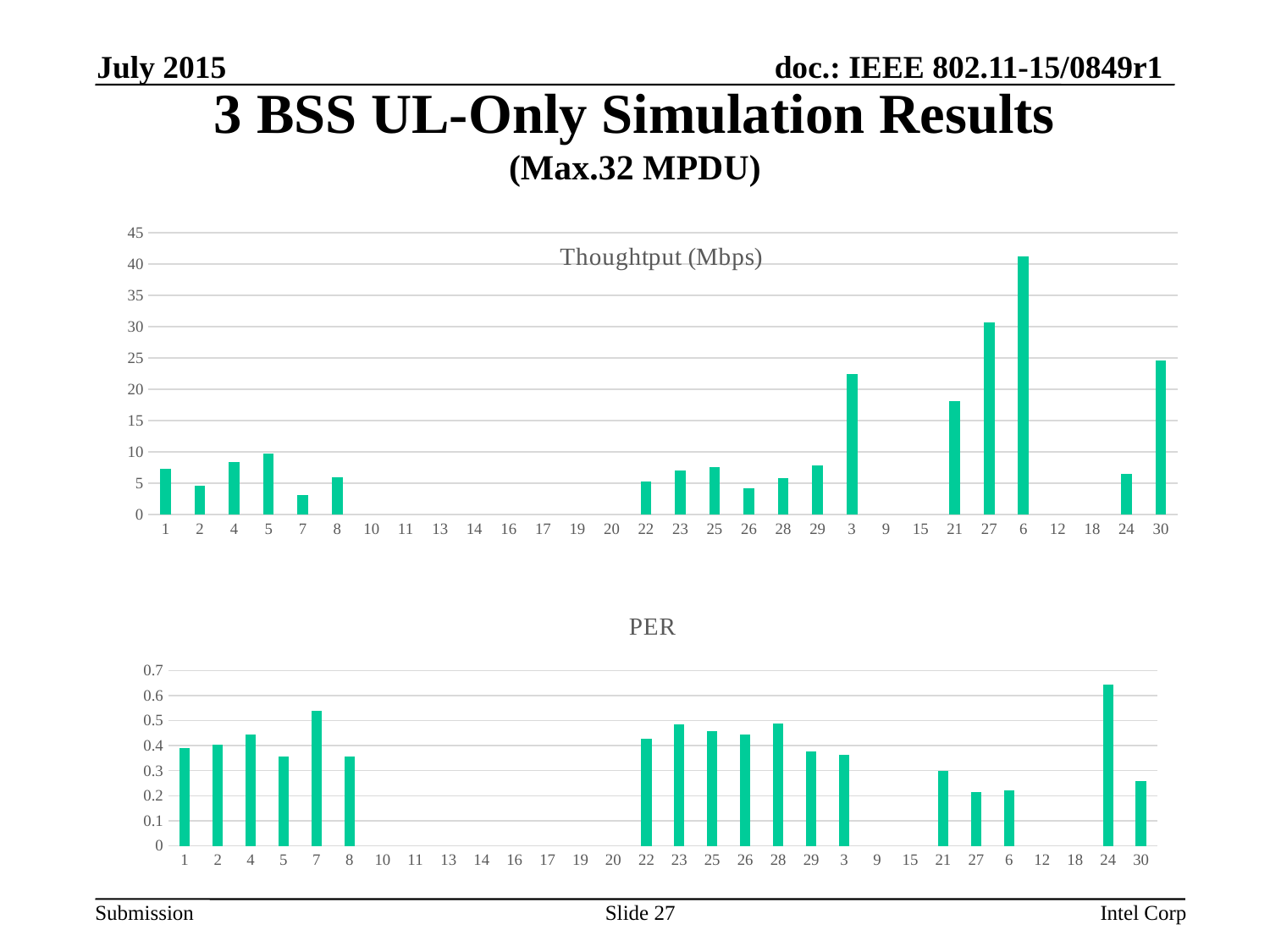
In the top chart (Thoughtput (Mbps)), which is larger, the value for category 6 or category 27? 6 In the bottom chart (PER), is the value for category 27 greater or less than 0.3? less What kind of chart is the top chart titled "Thoughtput (Mbps)"? bar chart In the top chart (Thoughtput (Mbps)), is the value for category 21 greater or less than 15? greater In the top chart (Thoughtput (Mbps)), is the value for category 27 greater or less than 25? greater In the top chart (Thoughtput (Mbps)), which category has the highest value? 6 What is the title of the bottom chart? PER In the bottom chart (PER), which is larger, the value for category 24 or category 30? 24 In the bottom chart (PER), which category has the highest value? 24